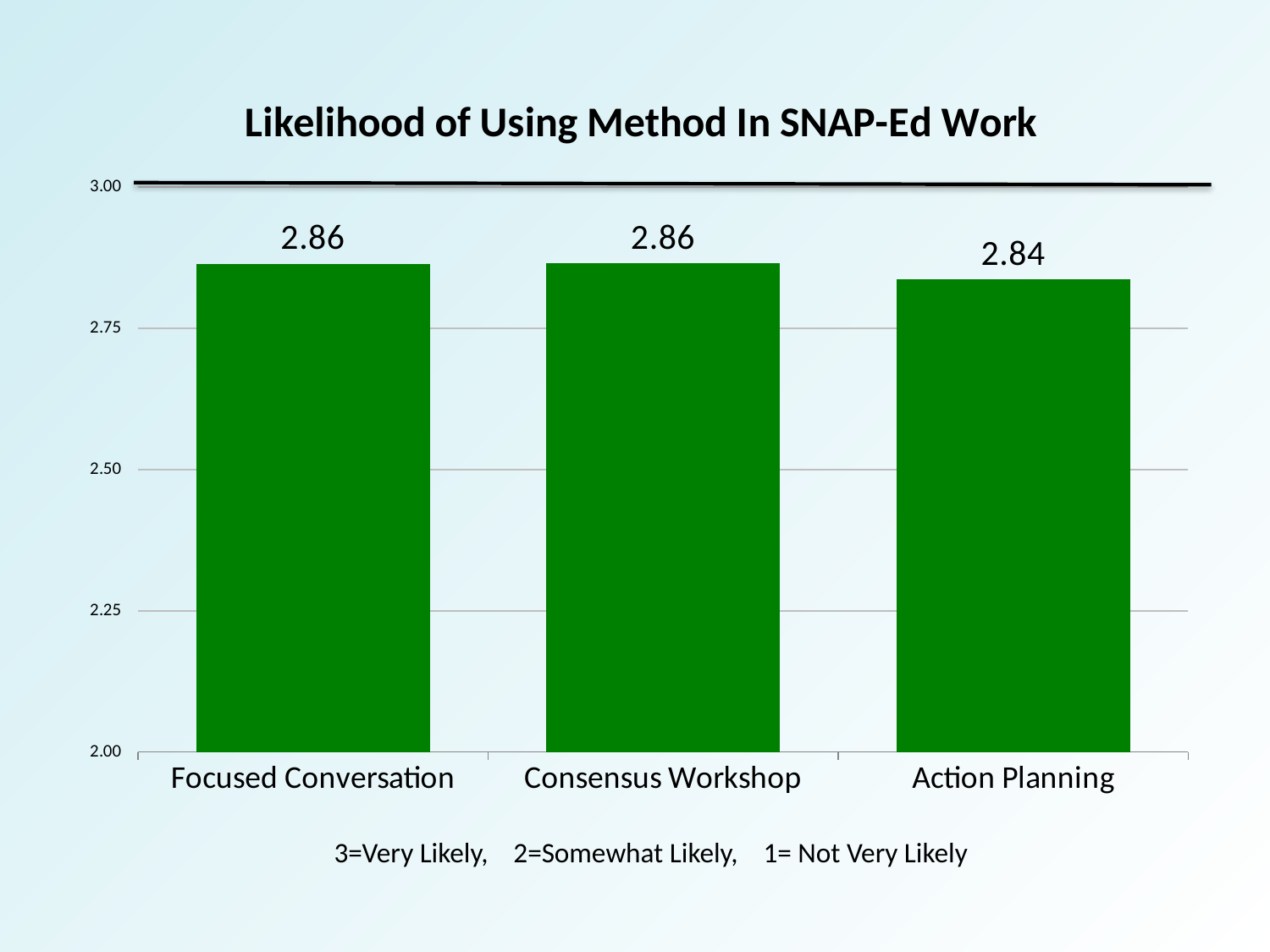
Is the value for Action Planning greater or less than 2.75? greater What colour are the bars in the chart? Green What is the value for Focused Conversation? 2.86 Which category has the lowest value? Action Planning Do the values rise or fall from Consensus Workshop to Action Planning? Fall What kind of chart is shown on the slide? Bar chart What is the title of the chart? Likelihood of Using Method In SNAP-Ed Work What is the value for Action Planning? 2.84 What is the difference between the values for Focused Conversation and Action Planning? 0.02 How many categories are shown on the x axis? 3 What is the value for Consensus Workshop? 2.86 Is the value for Consensus Workshop greater or less than 3.00? less